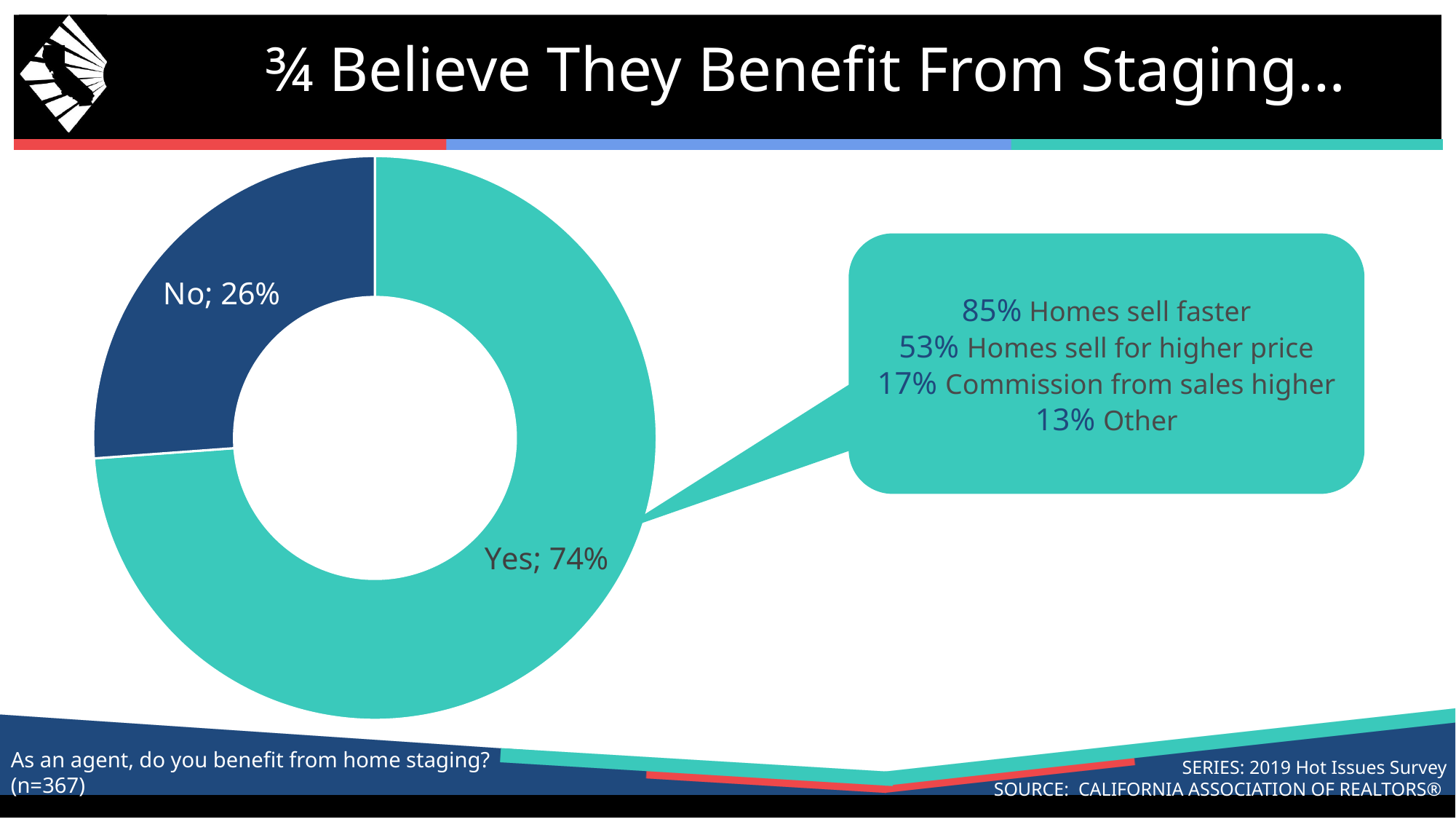
What is the share of the chart taken by the "No" slice? 26% What is the sample size (n) shown for the survey question? 367 What percentage of agents answered "No" to benefiting from home staging? 26% Which response has the larger share of the chart, Yes or No? Yes According to the callout box, what percentage said homes sell faster? 85% What percentage of agents answered "Yes" to benefiting from home staging? 74% What is the difference in percentage points between the Yes and No shares? 48 According to the callout box, what percentage said homes sell for a higher price? 53% How many categories are shown in the chart? 2 What colour is the "Yes" slice of the chart? Teal What kind of chart is shown on the slide? Doughnut (pie) chart Which response has the smallest share of the chart? No